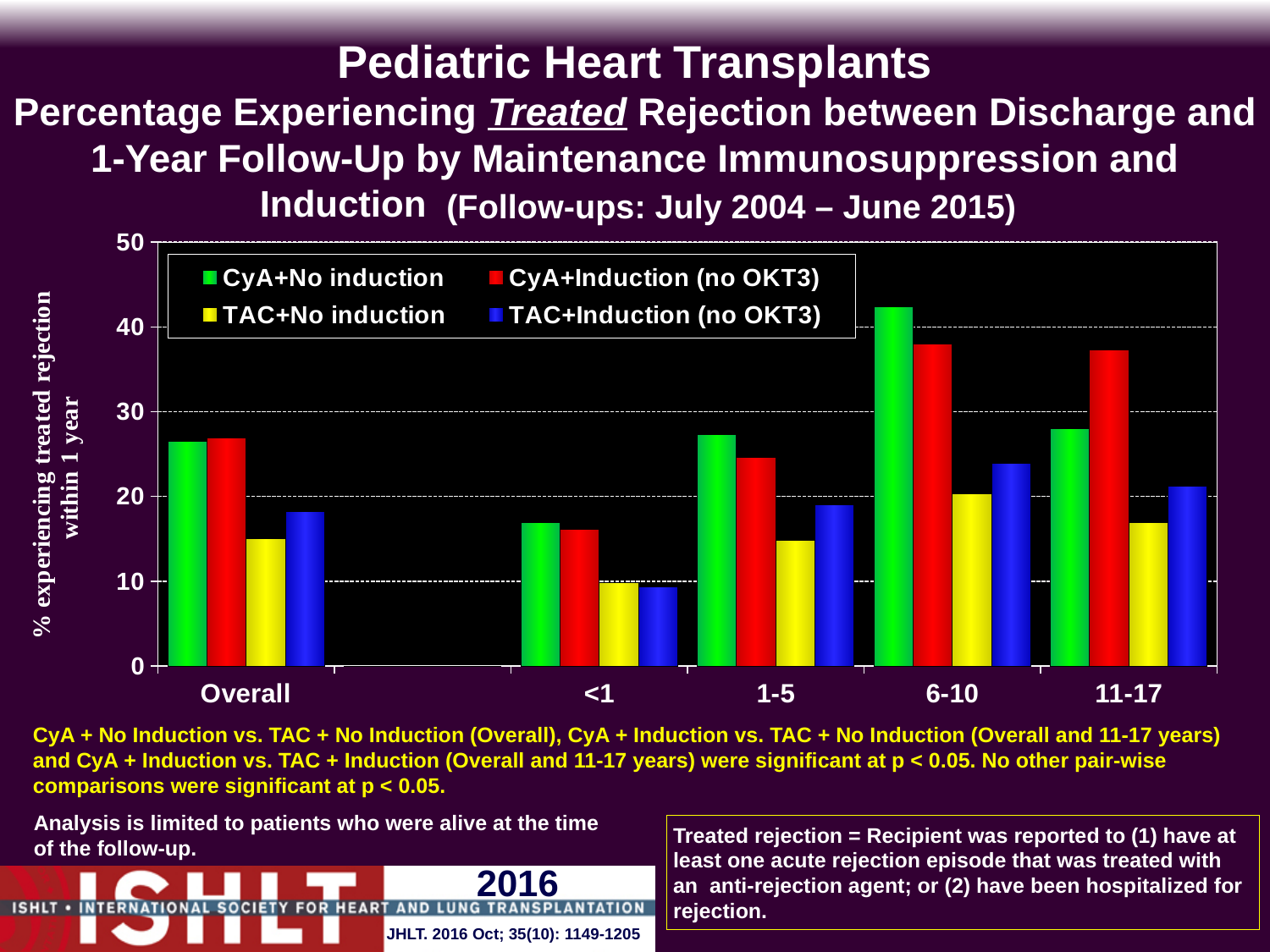
Is the value for TAC+No induction in the Overall group greater or less than 20? less Which category has the highest value for CyA+No induction? 6-10 In the 6-10 group, which is larger: TAC+Induction (no OKT3) or TAC+No induction? TAC+Induction (no OKT3) What colour represents TAC+No induction in the legend? yellow Which category has the lowest value for TAC+No induction? <1 What kind of chart is shown on the slide? bar chart Is the value for CyA+No induction in the 6-10 group greater or less than 40? greater Is the value for CyA+Induction (no OKT3) in the 11-17 group greater or less than 30? greater How many series does the legend list? 4 In the 11-17 group, which is larger: CyA+Induction (no OKT3) or CyA+No induction? CyA+Induction (no OKT3) How many categories are shown along the x axis? 5